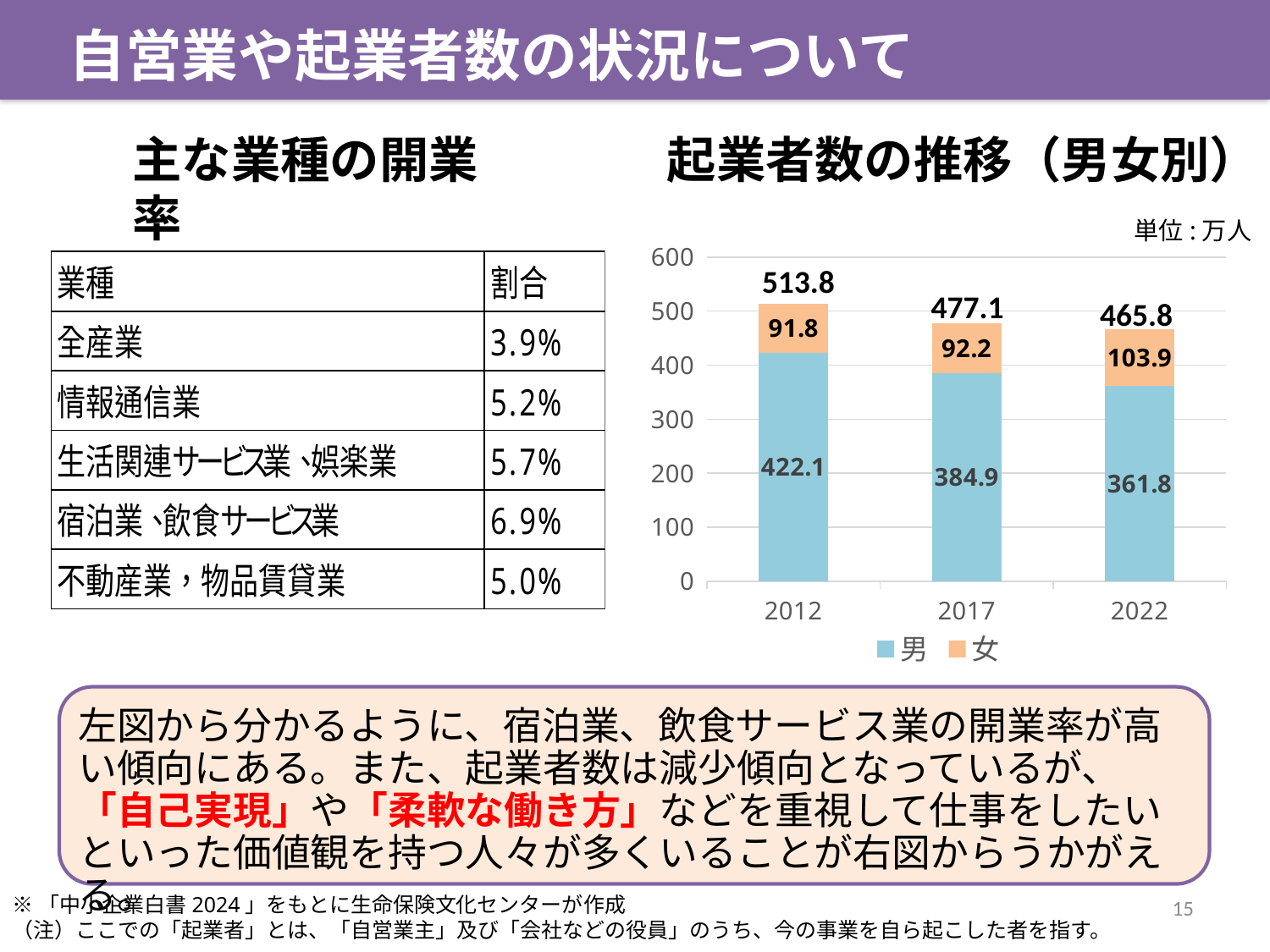
「起業者数の推移（男女別）」のグラフで、「男」の値が最も少ない年はどれですか。 2022 「起業者数の推移（男女別）」のグラフで、2017年の「女」と2022年の「女」ではどちらが大きいですか。 2022 「起業者数の推移（男女別）」のグラフで、2012年と2022年の「男」の値の差はいくつですか。 60.3 「起業者数の推移（男女別）」のグラフで、合計が最も多い年はどれですか。 2012 「起業者数の推移（男女別）」のグラフには、いくつの年が示されていますか。 3 「起業者数の推移（男女別）」のグラフの凡例には、いくつの系列がありますか。 2 「起業者数の推移（男女別）」のグラフの単位は何ですか。 万人 「起業者数の推移（男女別）」のグラフで、2022年の「女」の値はいくつですか。 103.9 「起業者数の推移（男女別）」のグラフで、2017年の合計値はいくつですか。 477.1 「起業者数の推移（男女別）」のグラフで、2012年から2022年にかけて合計値は増加していますか、減少していますか。 減少 「起業者数の推移（男女別）」のグラフはどの種類のグラフですか。 積み上げ棒グラフ 「起業者数の推移（男女別）」のグラフで、2012年の「男」の値はいくつですか。 422.1